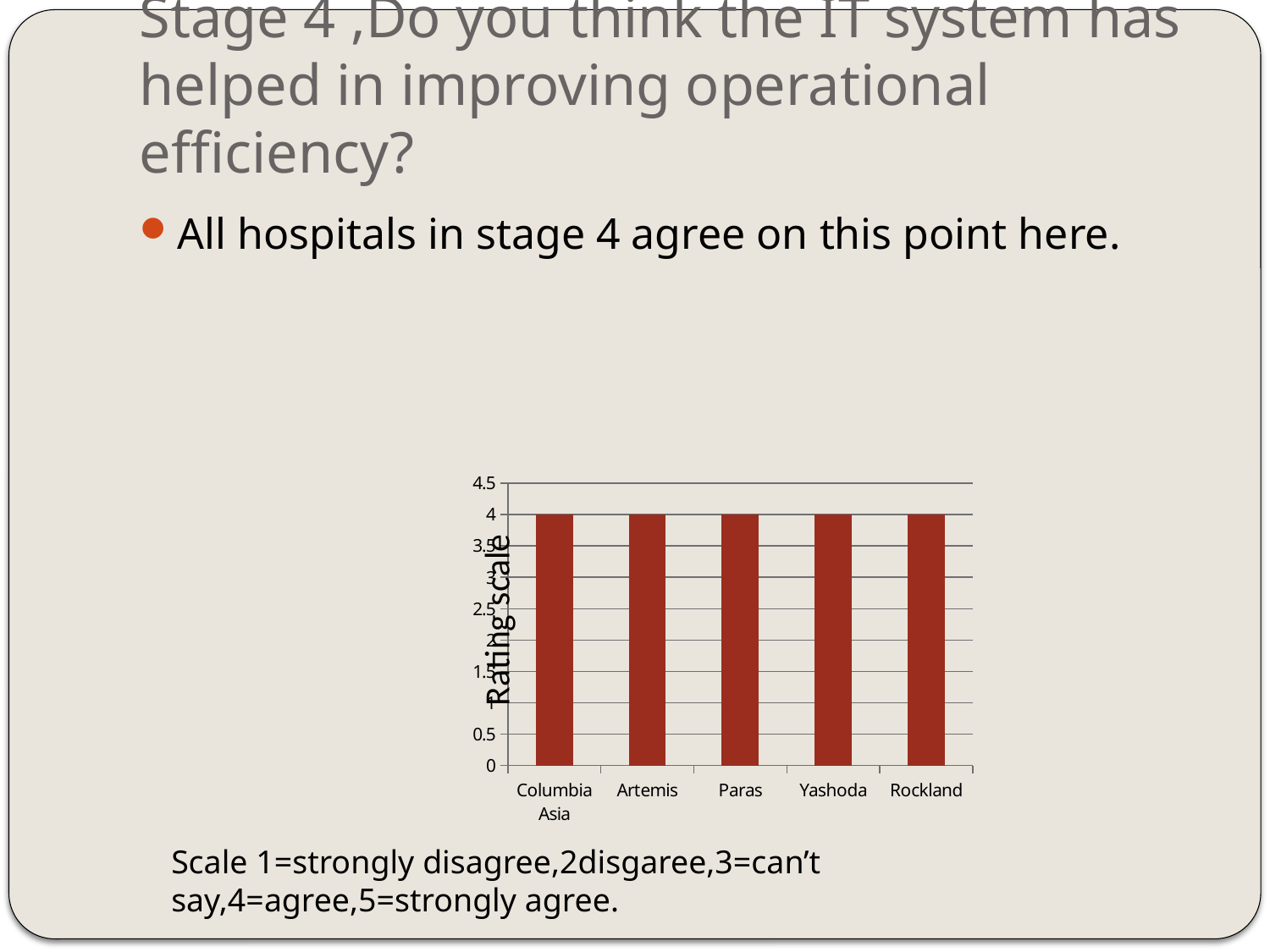
What is the label on the vertical axis of the chart? Rating scale What kind of chart is shown on the slide? bar chart Is the value for Paras greater or less than 4.5? less What is the rating value for Columbia Asia? 4 What is the rating value for Artemis? 4 Is the value for Yashoda greater or less than 3.5? greater What is the rating value for Rockland? 4 Do the values rise, fall, or stay the same across the hospitals along the x axis? stay the same What is the difference between the rating for Artemis and the rating for Rockland? 0 What is the rating value for Paras? 4 How many hospitals are shown on the x axis of the chart? 5 What is the rating value for Yashoda? 4